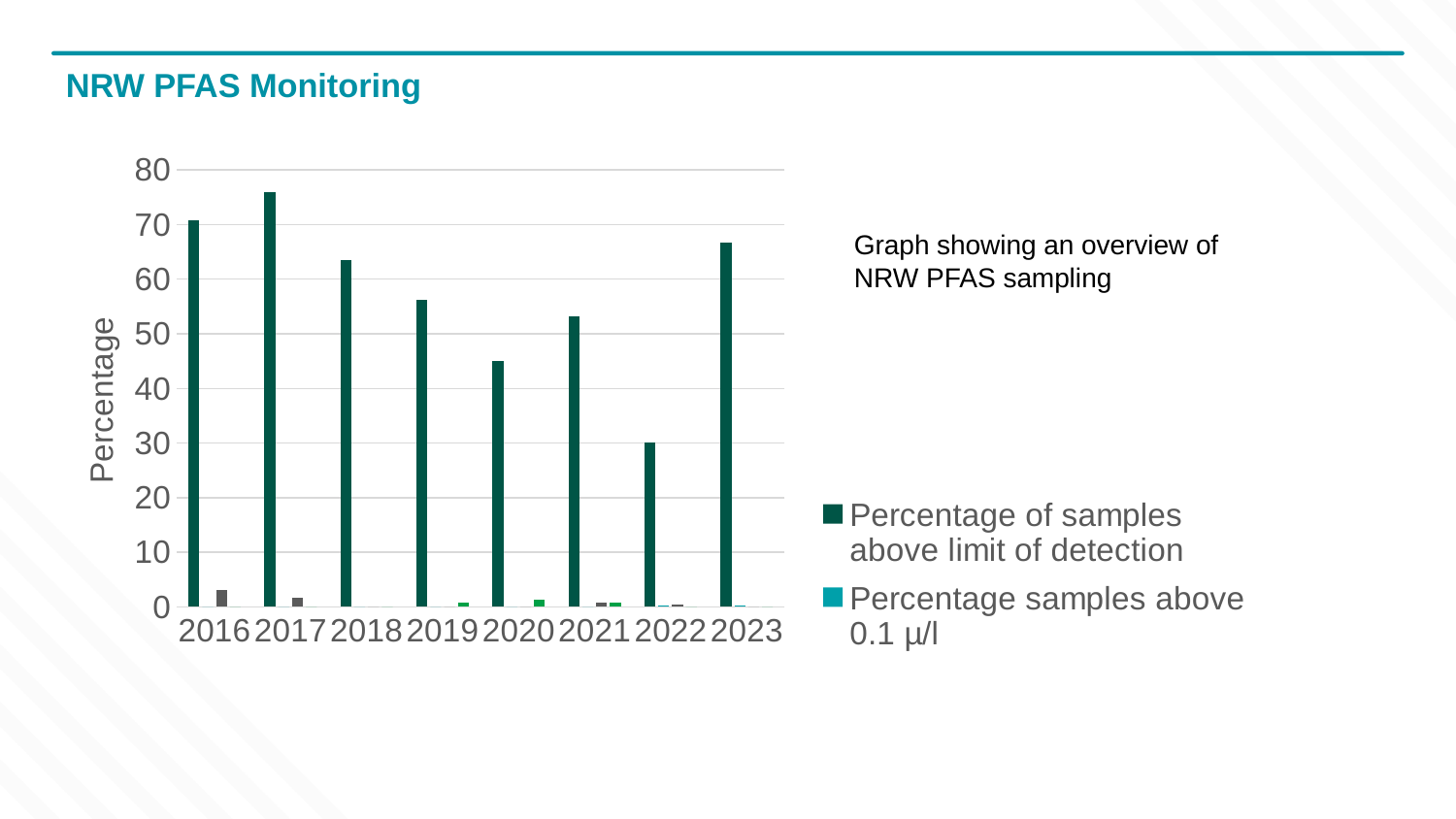
Which year has the highest percentage of samples above limit of detection? 2017 Which year has a higher percentage of samples above limit of detection, 2022 or 2023? 2023 How many years are shown on the x axis of the chart? 8 What is the first series listed in the chart legend? Percentage of samples above limit of detection How many series does the chart legend list? 2 Which year has the lowest percentage of samples above limit of detection? 2022 Which year has a higher percentage of samples above limit of detection, 2016 or 2020? 2016 What is the label on the vertical axis of the chart? Percentage Is the percentage of samples above limit of detection for 2020 greater or less than 50? less Is the percentage of samples above limit of detection for 2017 greater or less than 70? greater What kind of chart is shown on the slide? bar chart Is the percentage of samples above limit of detection for 2022 greater or less than 40? less